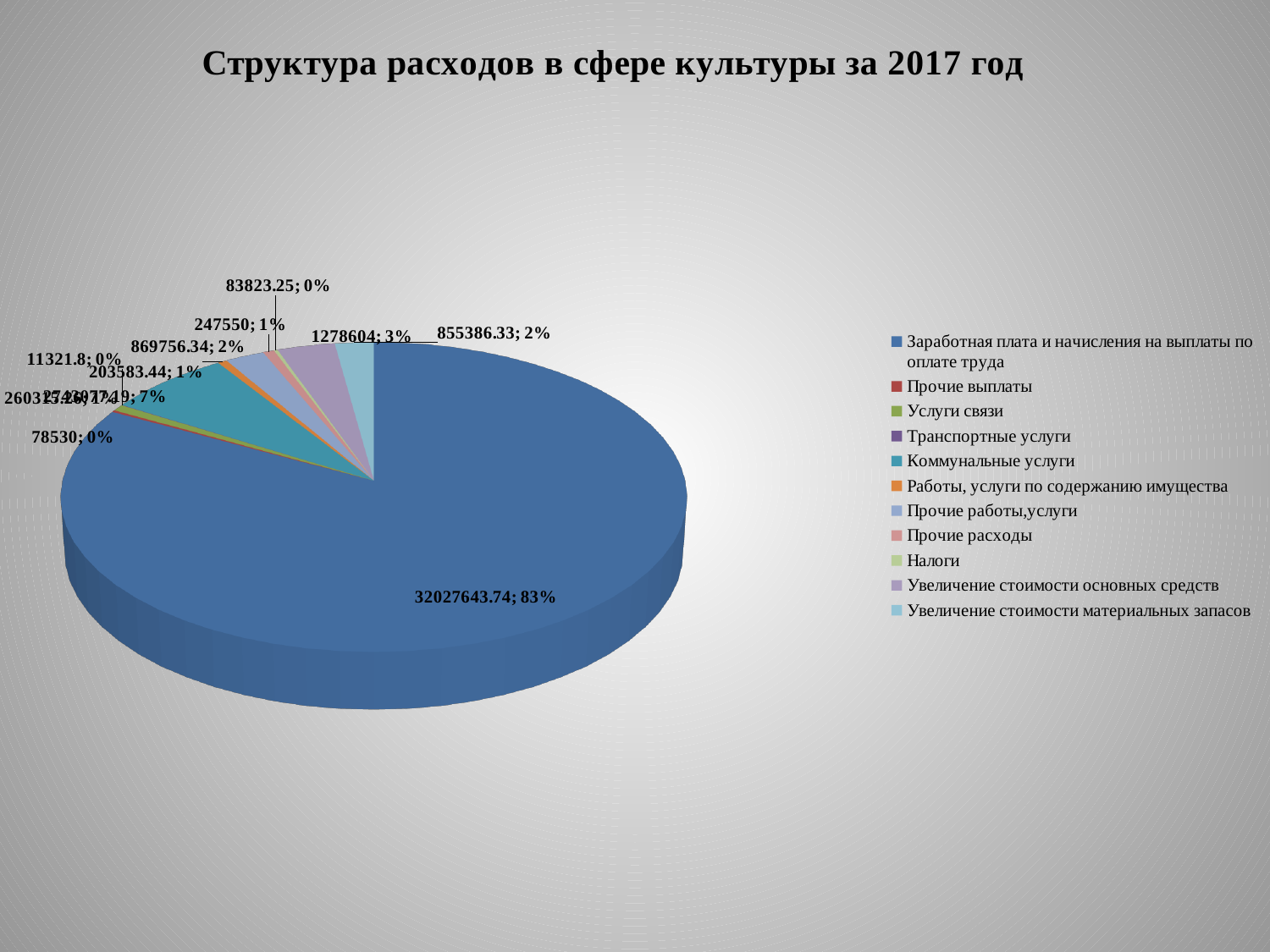
What share of the pie does Заработная плата и начисления на выплаты по оплате труда take? 83% What is the title of the chart? Структура расходов в сфере культуры за 2017 год Which category is listed first in the legend? Заработная плата и начисления на выплаты по оплате труда What value is shown for Заработная плата и начисления на выплаты по оплате труда? 32027643.74 Which is larger: the share for Заработная плата и начисления на выплаты по оплате труда or the share for Коммунальные услуги? Заработная плата и начисления на выплаты по оплате труда What type of chart is shown on the slide? Pie chart Which data value on the pie chart is labeled with a 3% share? 1278604 What is the difference in percentage points between the share for Заработная плата и начисления на выплаты по оплате труда (83%) and the share for Коммунальные услуги (7%)? 76 What share of the pie does Коммунальные услуги take? 7% How many categories does the legend of the pie chart list? 11 Which category has the largest share of the pie? Заработная плата и начисления на выплаты по оплате труда Which two data values on the pie chart are labeled with a 2% share? 869756.34 and 855386.33